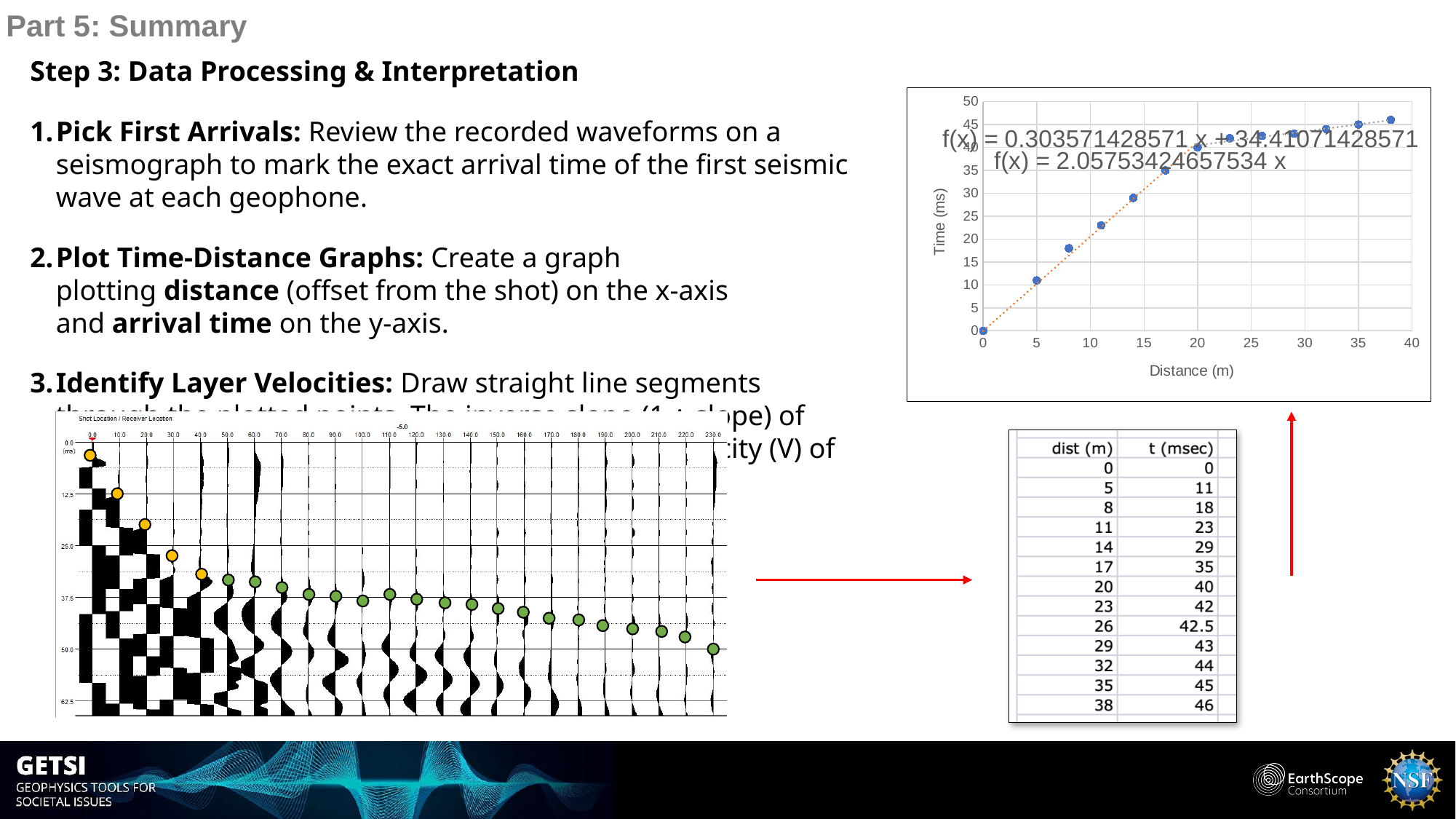
In the top-right chart, what is the label of the x axis? Distance (m) In the top-right chart, do the arrival times rise or fall as distance increases? rise In the top-right chart, is the arrival time at a distance of 14 m greater or less than 25? greater In the top-right chart, what is the arrival time at a distance of 20 m? 40 In the top-right chart, what is the label of the y axis? Time (ms) In the top-right chart, is the arrival time at a distance of 5 m greater or less than 15? less In the top-right chart, what is the arrival time at a distance of 0 m? 0 In the top-right chart, which has the larger arrival time: the point at 17 m or the point at 11 m? 17 m In the top-right chart, which distance has the lowest arrival time? 0 In the top-right chart, which distance has the highest arrival time? 38 How many data points are plotted in the top-right time-distance chart? 13 What kind of chart is the chart in the top right of the slide? scatter chart